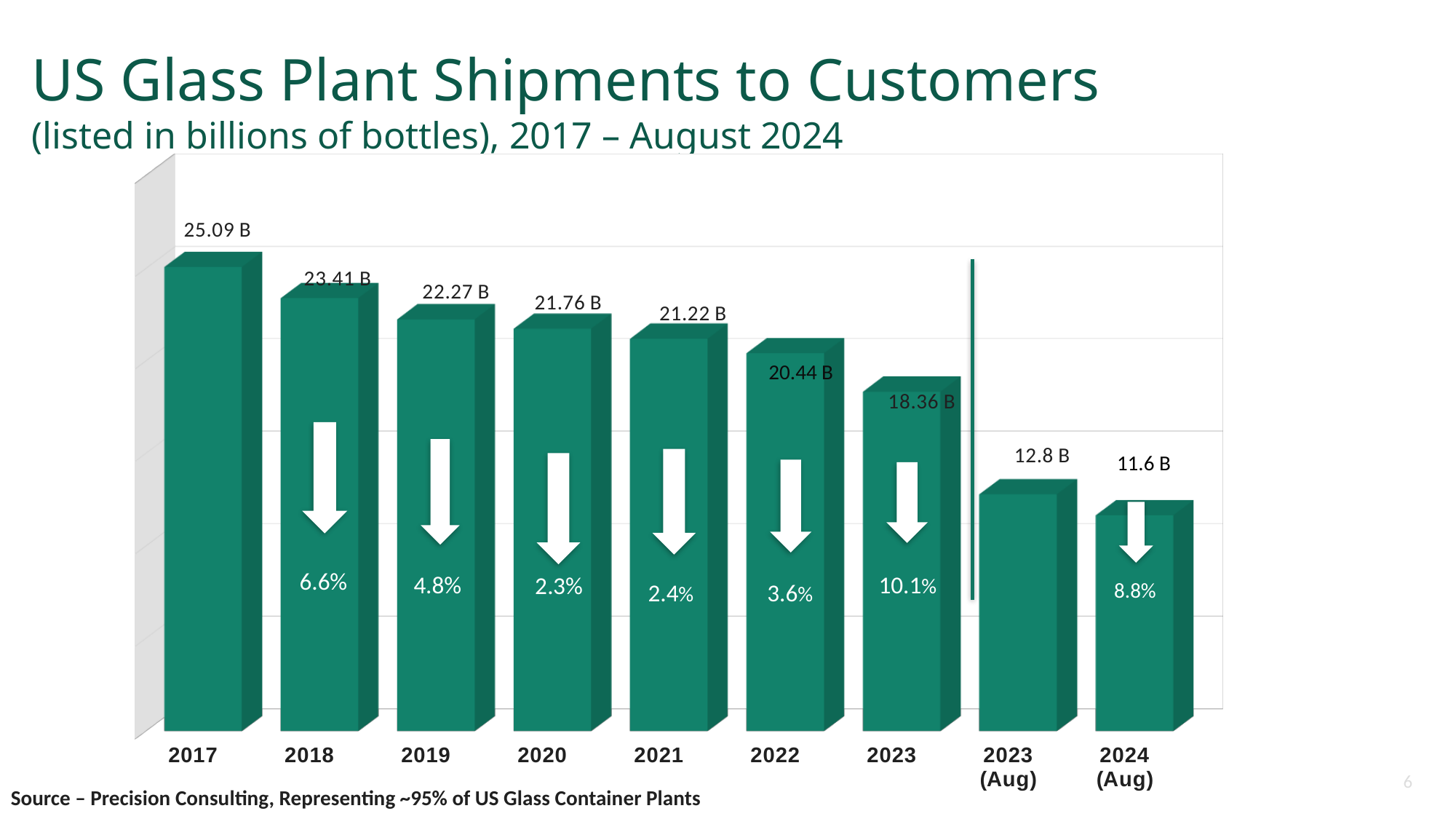
Which category has the lowest value? 2024 (Aug) Which is larger, the value for 2021 or the value for 2022? 2021 How many bars are shown in the chart? 9 What is the value for 2023 (Aug)? 12.8 B Which category has the highest value? 2017 What kind of chart is shown on the slide? Bar chart What percentage decline is shown on the 2023 bar? 10.1% What is the value for 2017? 25.09 B What percentage decline is shown on the 2024 (Aug) bar? 8.8% What is the value for 2020? 21.76 B What is the difference between the values for 2017 and 2018? 1.68 B What is the difference between the values for 2023 (Aug) and 2024 (Aug)? 1.2 B